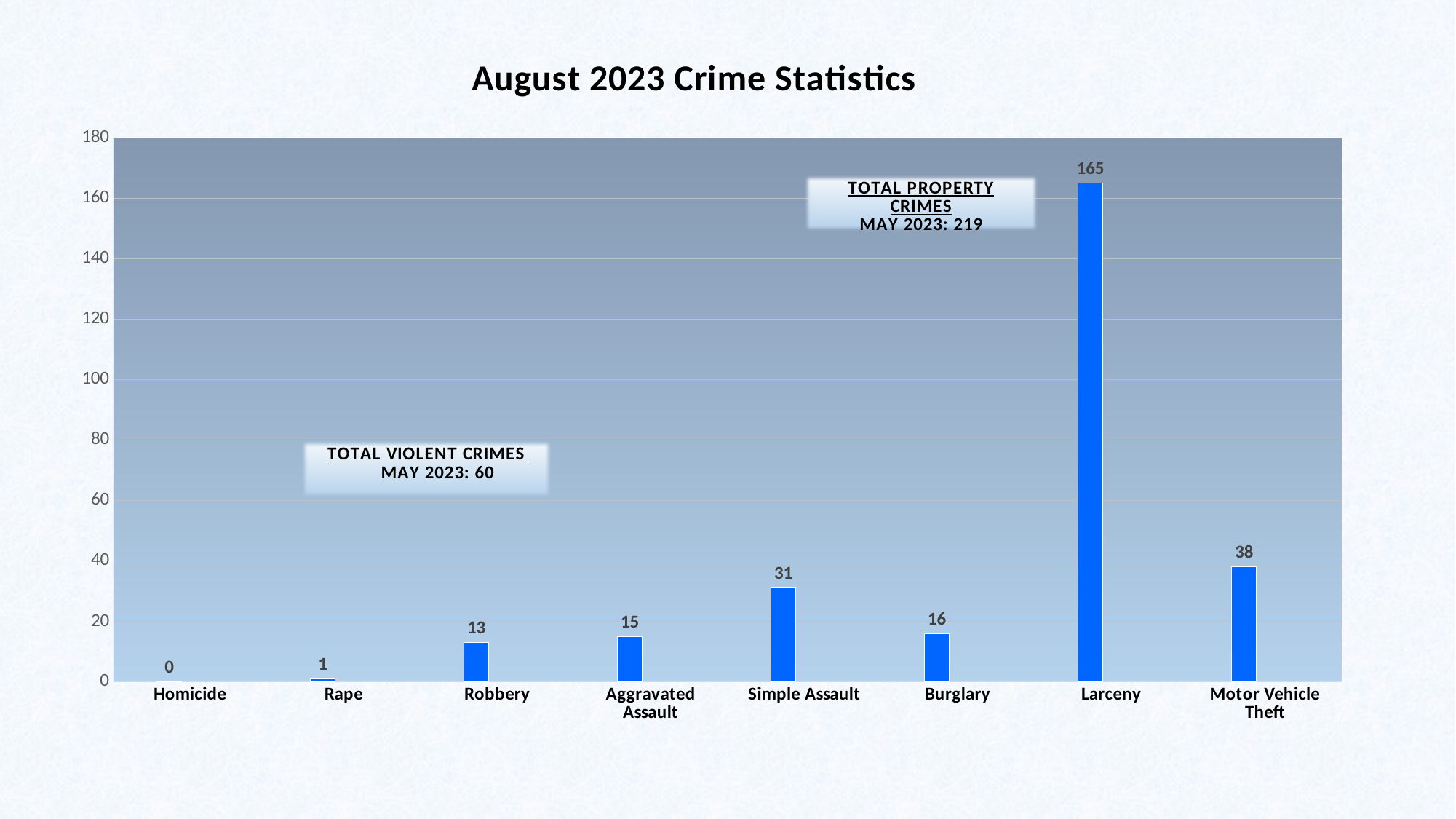
How many categories are shown on the x axis? 8 What is the value for Motor Vehicle Theft? 38 What kind of chart is shown on the slide? bar chart Which category has the lowest value? Homicide Is the value for Simple Assault greater or less than 40? less Which category has the highest value? Larceny What is the value for Simple Assault? 31 What is the difference between the values for Larceny and Motor Vehicle Theft? 127 What total is given in the text box labelled TOTAL PROPERTY CRIMES for May 2023? 219 What is the title of the chart? August 2023 Crime Statistics What is the value for Larceny? 165 Which is larger, the value for Burglary or the value for Robbery? Burglary